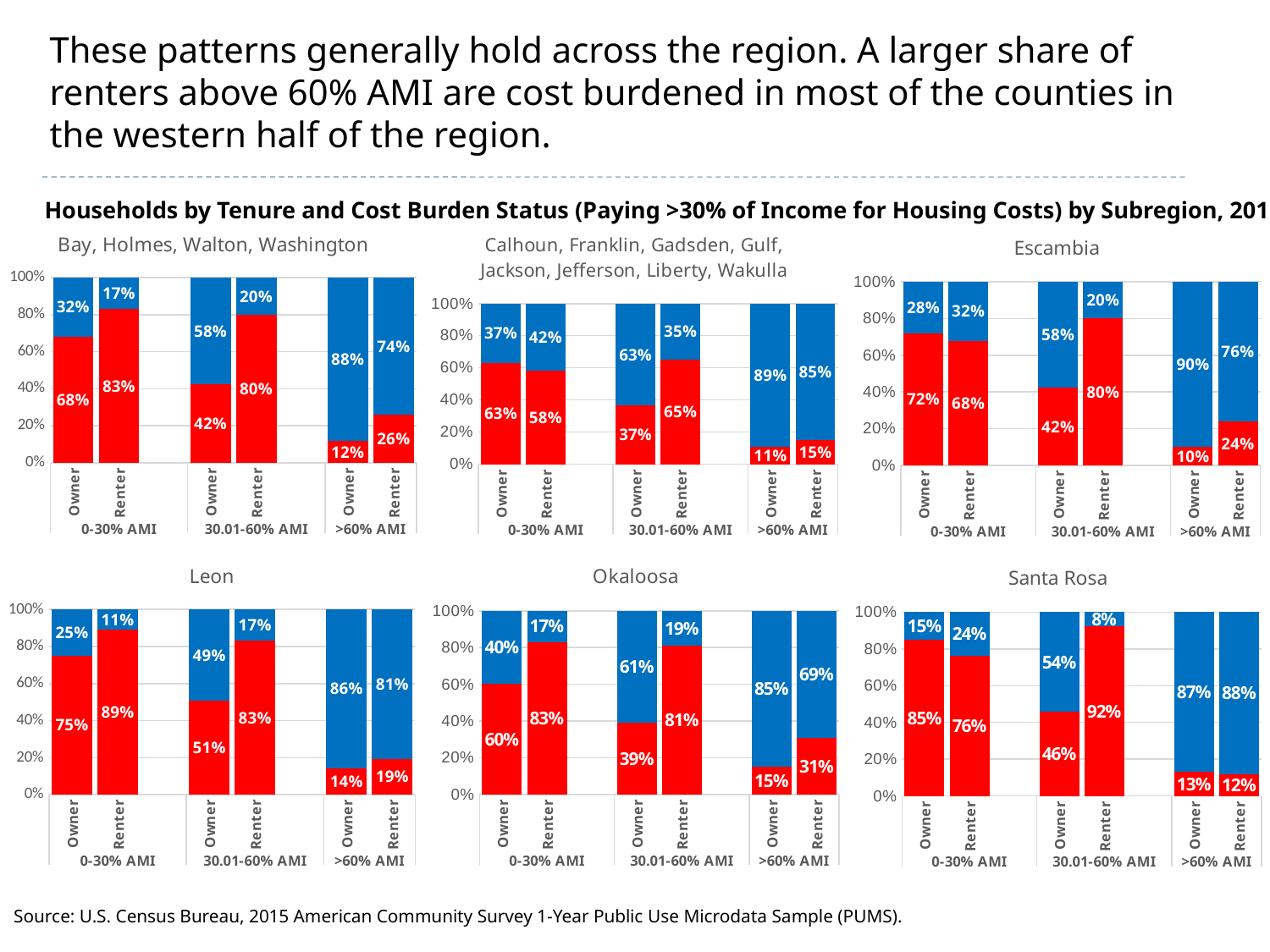
In the Leon chart, what is the value of the red segment for Renter in the 0-30% AMI group? 89% In the Santa Rosa chart, what is the value of the blue segment for Renter in the 30.01-60% AMI group? 8% How many bars are plotted in the Leon chart? 6 In the Okaloosa chart, what is the value of the red segment for Renter in the >60% AMI group? 31% In the Santa Rosa chart, which bar has the largest red segment? Renter, 30.01-60% AMI In the Calhoun, Franklin, Gadsden, Gulf, Jackson, Jefferson, Liberty, Wakulla chart, what is the value of the blue segment for Owner in the 30.01-60% AMI group? 63% In the Escambia chart, what is the value of the red segment for Owner in the 0-30% AMI group? 72% In the Escambia chart, what is the difference between the red segment for Renter and the red segment for Owner in the >60% AMI group? 14 percentage points In the Leon chart, which bar has the smallest blue segment? Renter, 0-30% AMI What kind of chart is used for each county group on this slide? Stacked bar chart In the Okaloosa chart, which has the larger red segment in the 0-30% AMI group, Owner or Renter? Renter In the Bay, Holmes, Walton, Washington chart, what is the value of the red segment for Owner in the >60% AMI group? 12%